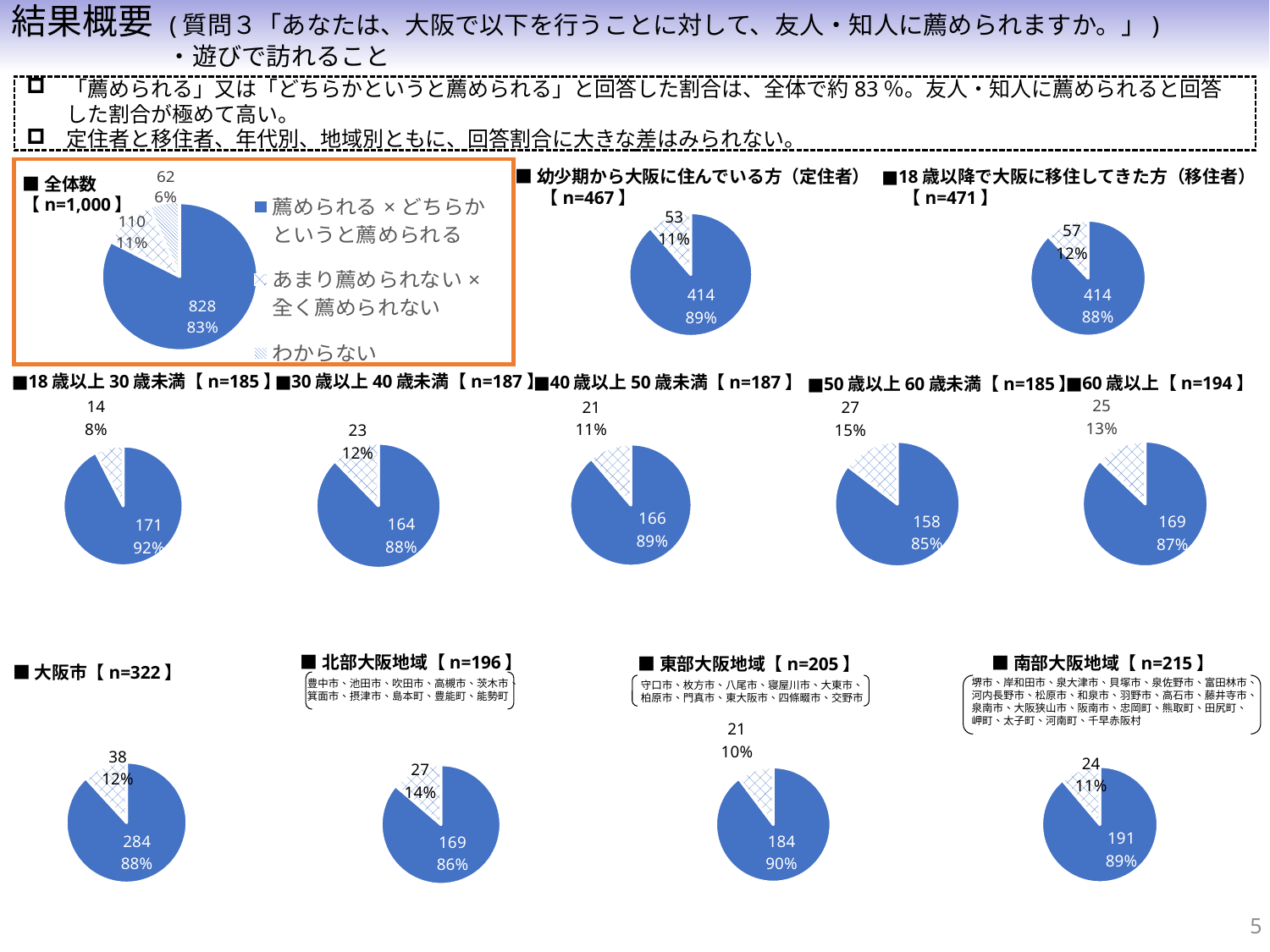
In the 18歳以降で大阪に移住してきた方（移住者）【n=471】 pie chart, what percentage is shown for the smaller slice? 12% Among the five age-group pie charts (18歳以上30歳未満 through 60歳以上), which group shows the highest percentage for the largest slice? 18歳以上30歳未満 What type of chart is used for the 全体数【n=1,000】 data? Pie chart Which is larger: the percentage of the largest slice in the 東部大阪地域【n=205】 pie chart or in the 北部大阪地域【n=196】 pie chart? 東部大阪地域 In the 幼少期から大阪に住んでいる方（定住者）【n=467】 pie chart, what count is shown for the largest slice? 414 In the 全体数【n=1,000】 pie chart, what count is shown for the わからない slice? 62 In the 50歳以上60歳未満【n=185】 pie chart, what is the difference in count between the two slices (158 and 27)? 131 In the 全体数【n=1,000】 pie chart, what percentage is shown for the 薦められる × どちらかというと薦められる slice? 83% How many entries does the legend of the 全体数【n=1,000】 pie chart list? 3 Among the five age-group pie charts (18歳以上30歳未満 through 60歳以上), which group shows the lowest percentage for the largest slice? 50歳以上60歳未満 In the 南部大阪地域【n=215】 pie chart, what percentage is shown for the largest slice? 89% In the 大阪市【n=322】 pie chart, what count is shown for the smaller slice? 38